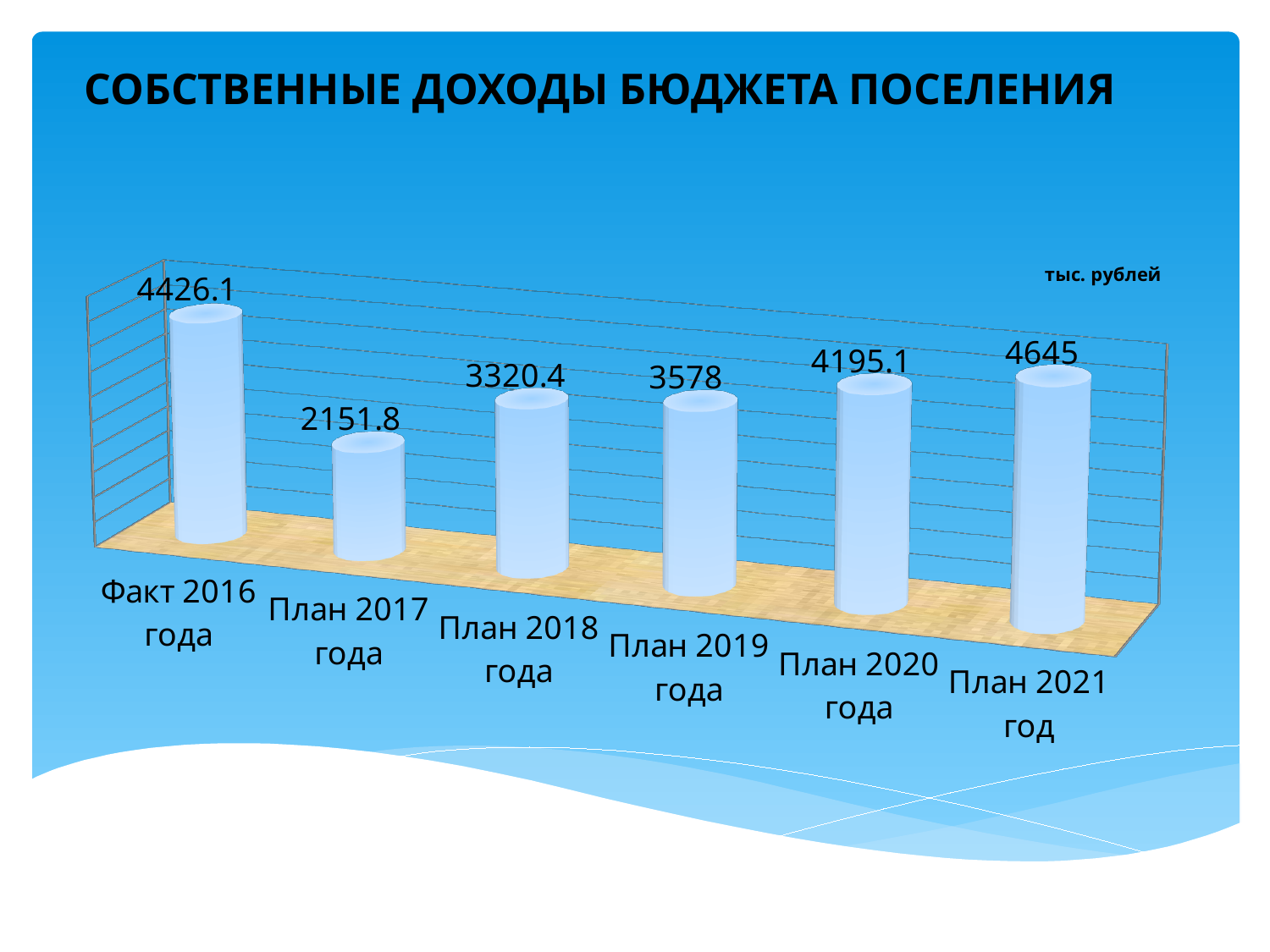
What is the value for Факт 2016 года? 4426.1 Which category has the highest value according to the data labels? План 2021 год What kind of chart is shown on the slide? Bar chart What is the difference between the values for План 2021 год and Факт 2016 года? 218.9 What is the value for План 2019 года? 3578 How many categories are shown on the chart? 6 What is the value for План 2020 года? 4195.1 What is the difference between the values for План 2020 года and План 2019 года? 617.1 Which is larger, the value for План 2018 года or the value for План 2019 года? План 2019 года Which category has the lowest value? План 2017 года What is the value for План 2017 года? 2151.8 Do the values rise or fall from План 2017 года to План 2021 год? Rise